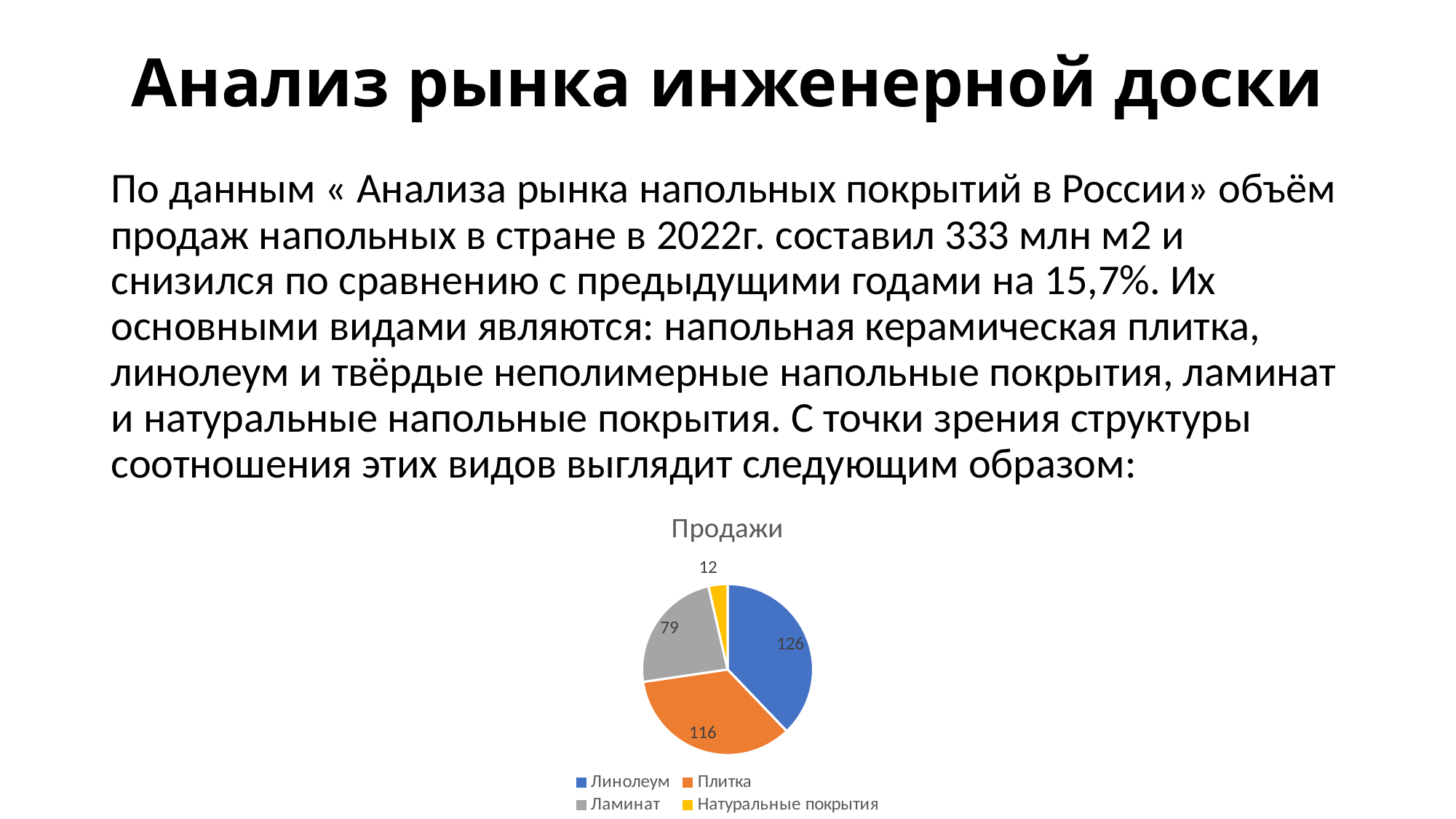
What is the difference between the values for Ламинат and Натуральные покрытия in the Продажи pie chart? 67 What is the value for Линолеум in the Продажи pie chart? 126 Which is larger in the Продажи pie chart, Плитка or Ламинат? Плитка Which category has the smallest slice in the Продажи pie chart? Натуральные покрытия What type of chart is shown on the slide? Pie chart What is the difference between the values for Линолеум and Плитка in the Продажи pie chart? 10 How many slices does the Продажи pie chart have? 4 What is the value for Ламинат in the Продажи pie chart? 79 Which category has the largest slice in the Продажи pie chart? Линолеум What is the value for Натуральные покрытия in the Продажи pie chart? 12 What is the value for Плитка in the Продажи pie chart? 116 What colour is the Ламинат slice in the Продажи pie chart? Gray